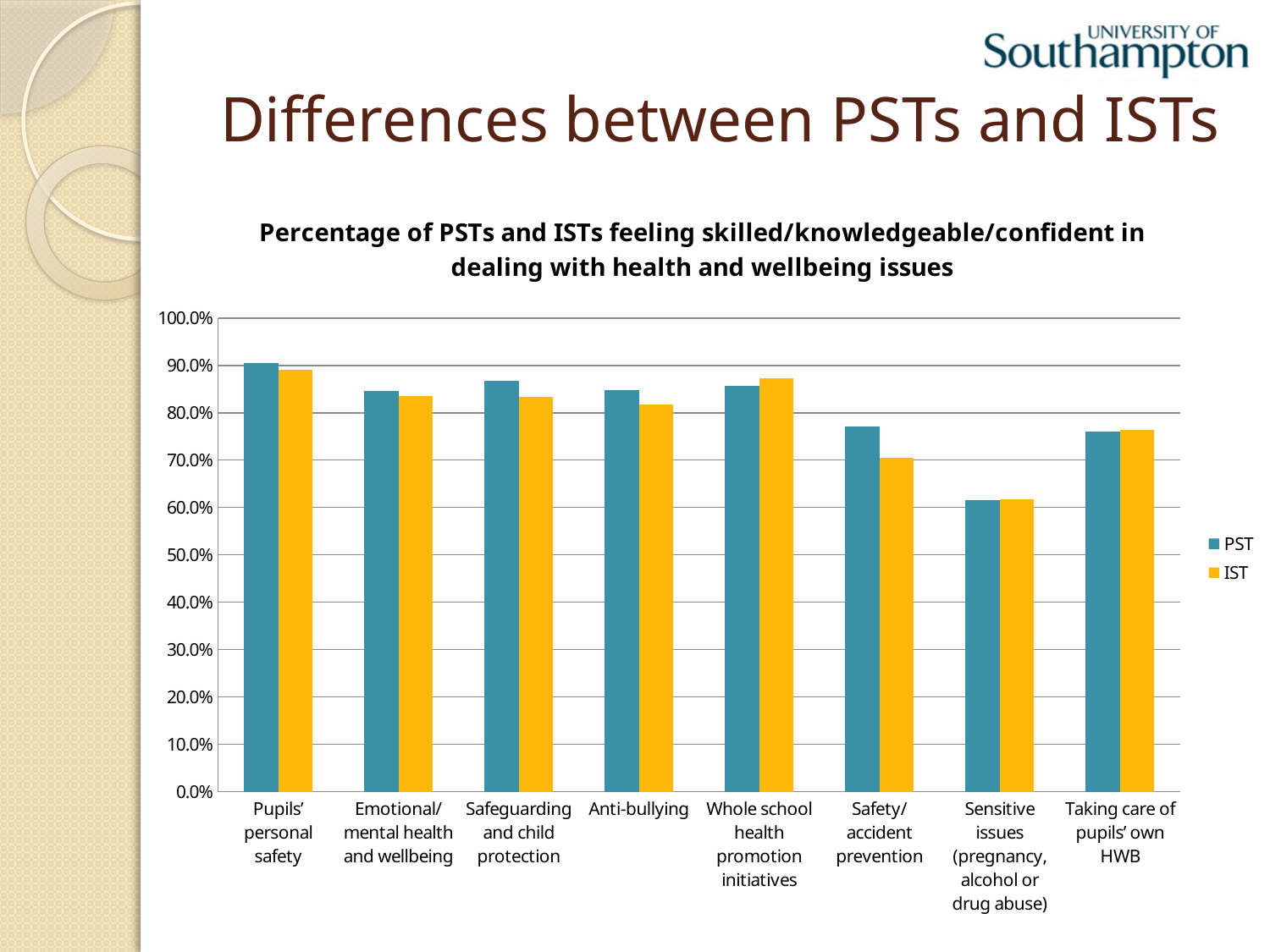
Is the PST value for Sensitive issues (pregnancy, alcohol or drug abuse) greater or less than 70.0%? less For Safety/accident prevention, which is larger, the PST value or the IST value? PST Is the IST value for Safety/accident prevention greater or less than 80.0%? less Which category has the highest PST value? Pupils' personal safety How many series does the legend list? 2 What kind of chart is shown on the slide? bar chart Is the IST value for Taking care of pupils' own HWB greater or less than 70.0%? greater Which category has the lowest PST value? Sensitive issues (pregnancy, alcohol or drug abuse) For Anti-bullying, which is larger, the PST value or the IST value? PST What are the two series named in the legend? PST and IST Which category has the lowest IST value? Sensitive issues (pregnancy, alcohol or drug abuse) How many categories are shown on the x axis of the chart? 8